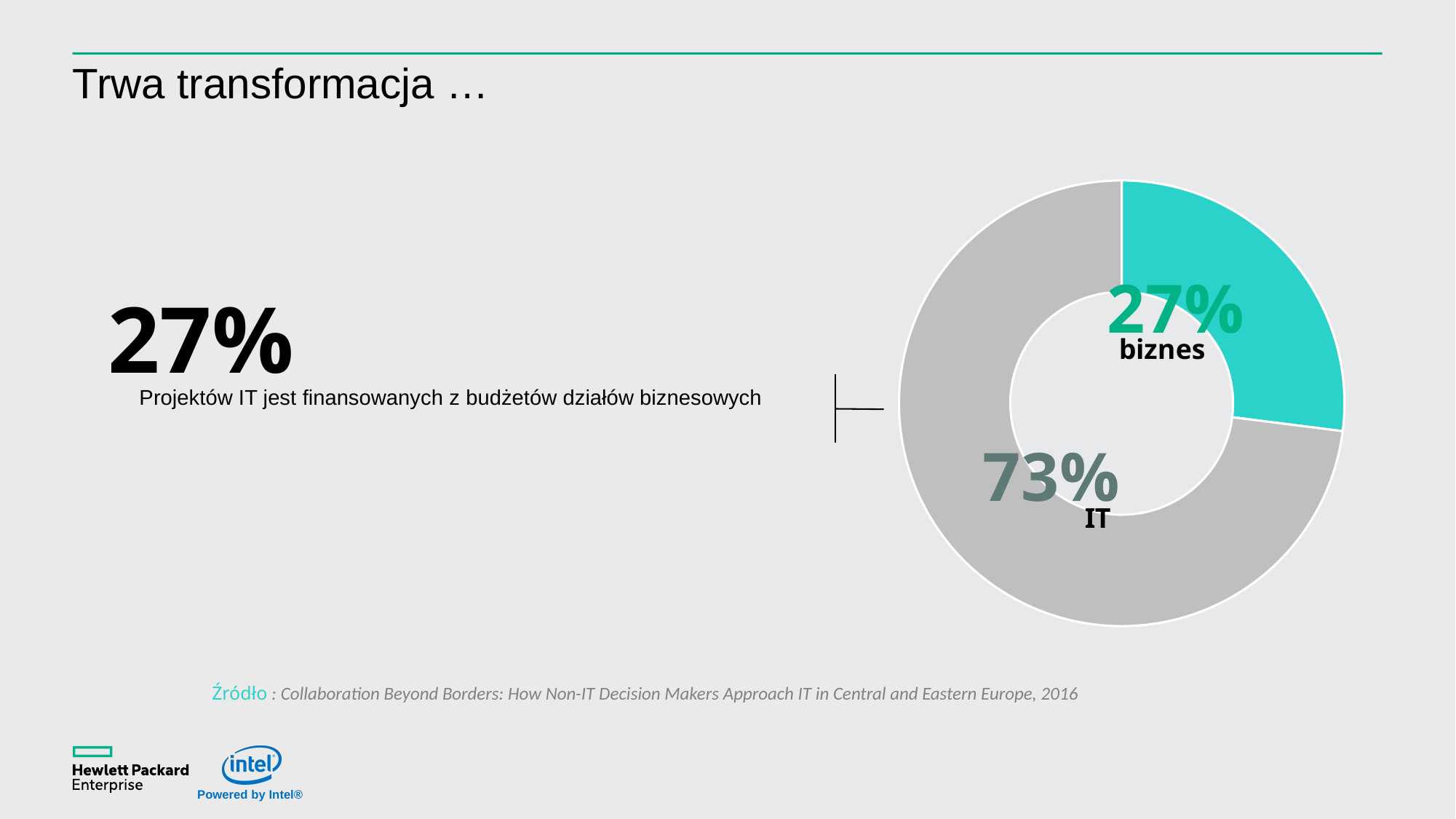
What colour is the IT slice? Grey What is the total of the two slices shown? 100% How many slices does the chart have? 2 Which slice is the largest? IT What is the difference in percentage points between the IT slice and the biznes slice? 46 Which slice is the smallest? biznes What share of the whole does the biznes slice represent? 27% What kind of chart is shown on the slide? Doughnut chart Which is larger, the IT slice or the biznes slice? IT What colour is the biznes slice? Teal (green) What percentage does the 'IT' slice show? 73% What percentage does the 'biznes' slice show? 27%